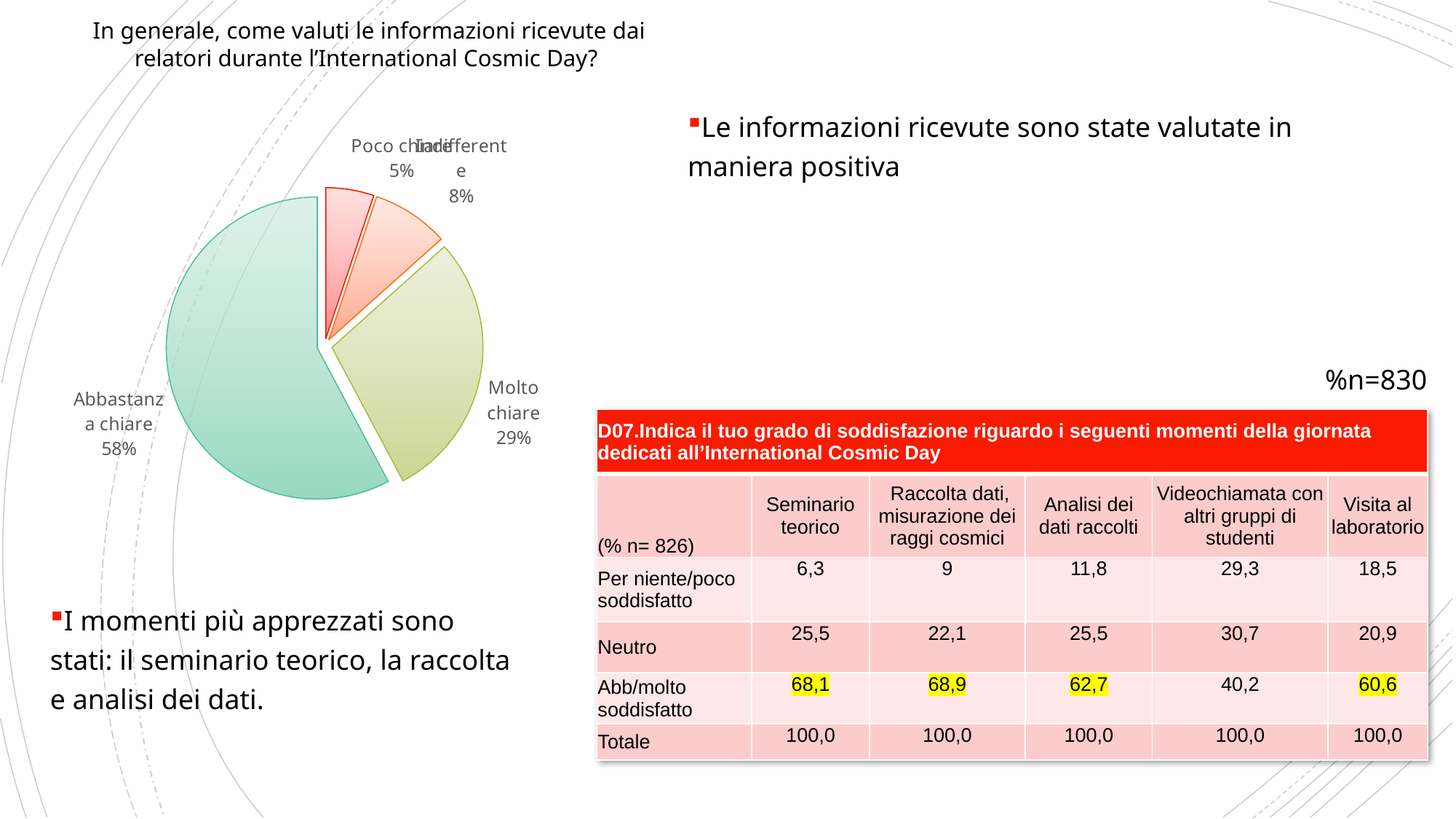
What is the difference in percentage points between 'Abbastanza chiare' and 'Molto chiare'? 29 What is the combined share of 'Abbastanza chiare' and 'Molto chiare' in the pie chart? 87% Which category has the smallest slice in the pie chart? Poco chiare What share of the pie chart is 'Abbastanza chiare'? 58% How many slices does the pie chart have? 4 What share of the pie chart is 'Molto chiare'? 29% What question does the pie chart's title ask? In generale, come valuti le informazioni ricevute dai relatori durante l'International Cosmic Day? What share of the pie chart is 'Indifferente'? 8% Which is larger in the pie chart, 'Indifferente' or 'Poco chiare'? Indifferente What type of chart is shown on the slide? Pie chart Which category has the largest slice in the pie chart? Abbastanza chiare